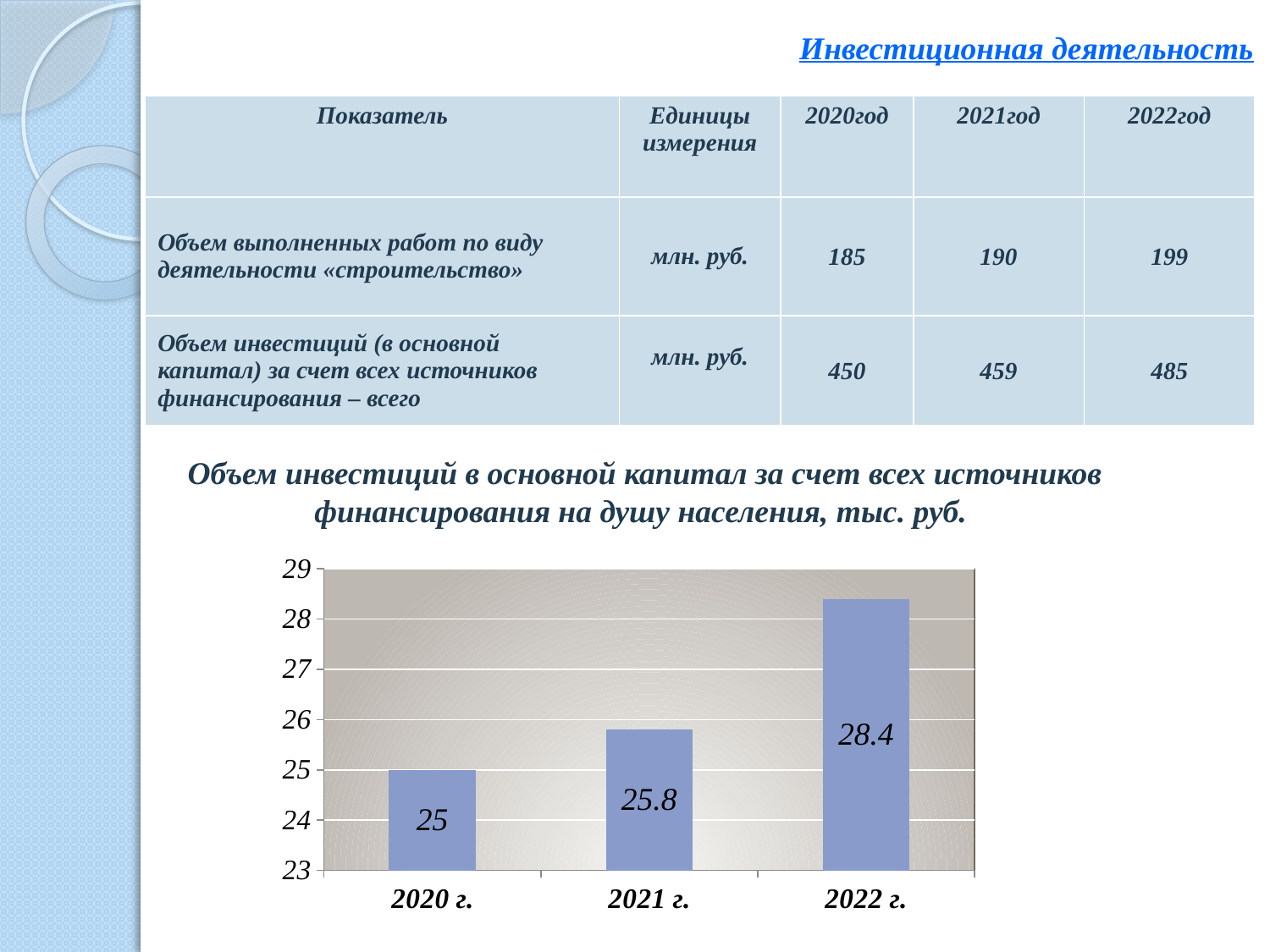
What is the value for 2022 г. in the chart? 28.4 Which is larger, the value for 2021 г. or the value for 2022 г.? 2022 г. Which year has the lowest value in the chart? 2020 г. What is the value for 2020 г. in the chart? 25 How many bars are shown in the chart? 3 What is the value for 2021 г. in the chart? 25.8 Do the values rise or fall from 2020 г. to 2022 г.? rise Is the value for 2022 г. greater or less than 27? greater Which year has the highest value in the chart? 2022 г. What is the difference between the values for 2021 г. and 2020 г.? 0.8 What is the difference between the values for 2022 г. and 2020 г.? 3.4 What kind of chart is shown on the slide? bar chart